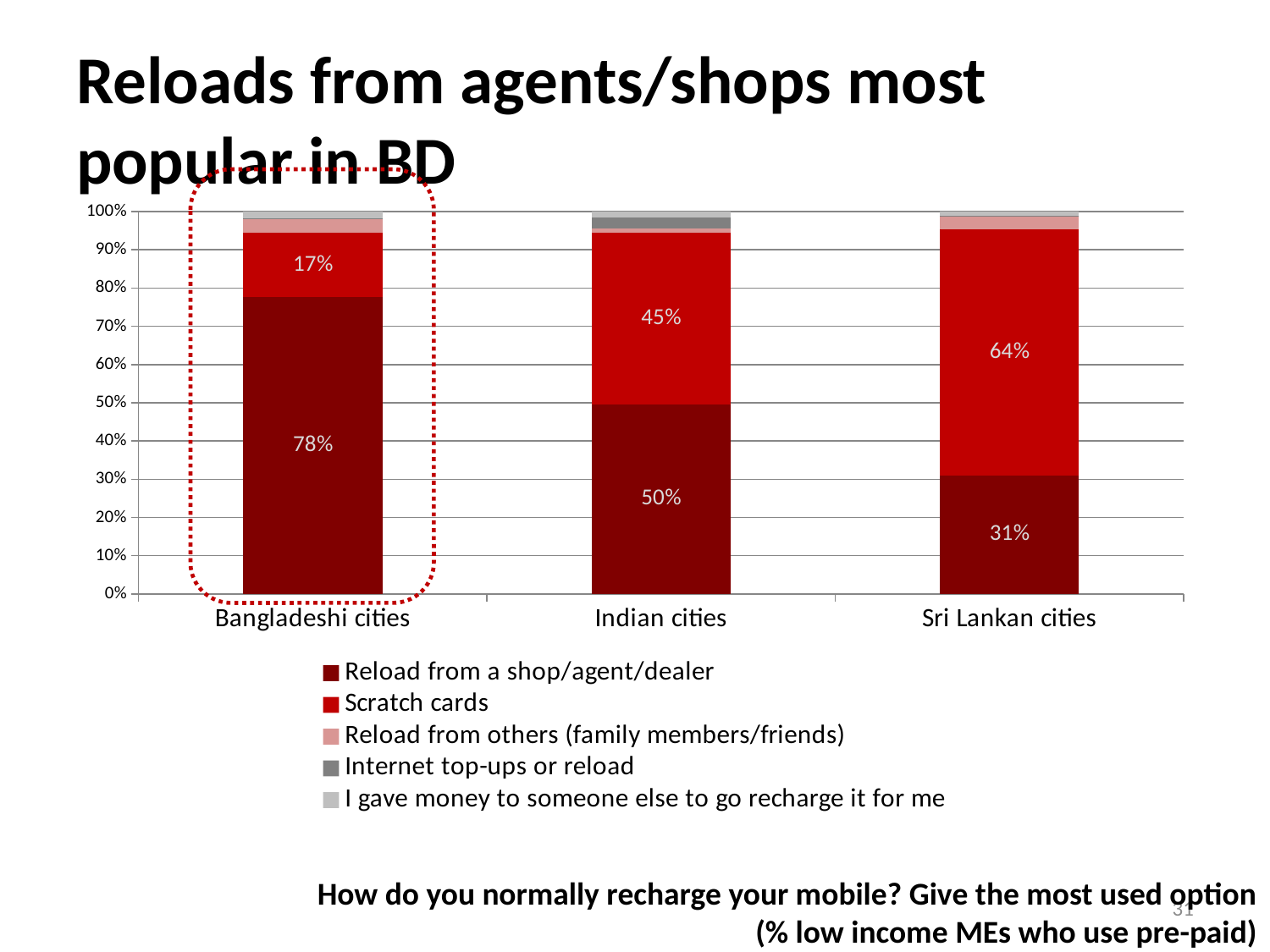
Which city group has the lowest value for Scratch cards? Bangladeshi cities How many city groups are shown on the x axis? 3 What is the value for Scratch cards in Sri Lankan cities? 64% What is the value for Scratch cards in Indian cities? 45% What is the value for Reload from a shop/agent/dealer in Sri Lankan cities? 31% In Indian cities, which is larger: Reload from a shop/agent/dealer or Scratch cards? Reload from a shop/agent/dealer Is the value for Reload from a shop/agent/dealer in Sri Lankan cities greater or less than 40%? less What percentage of respondents in Bangladeshi cities reload from a shop/agent/dealer? 78% How many series does the legend list? 5 What kind of chart is shown on the slide? Stacked bar chart Which city group has the highest value for Reload from a shop/agent/dealer? Bangladeshi cities What is the difference between the Reload from a shop/agent/dealer values for Bangladeshi cities and Indian cities? 28 percentage points